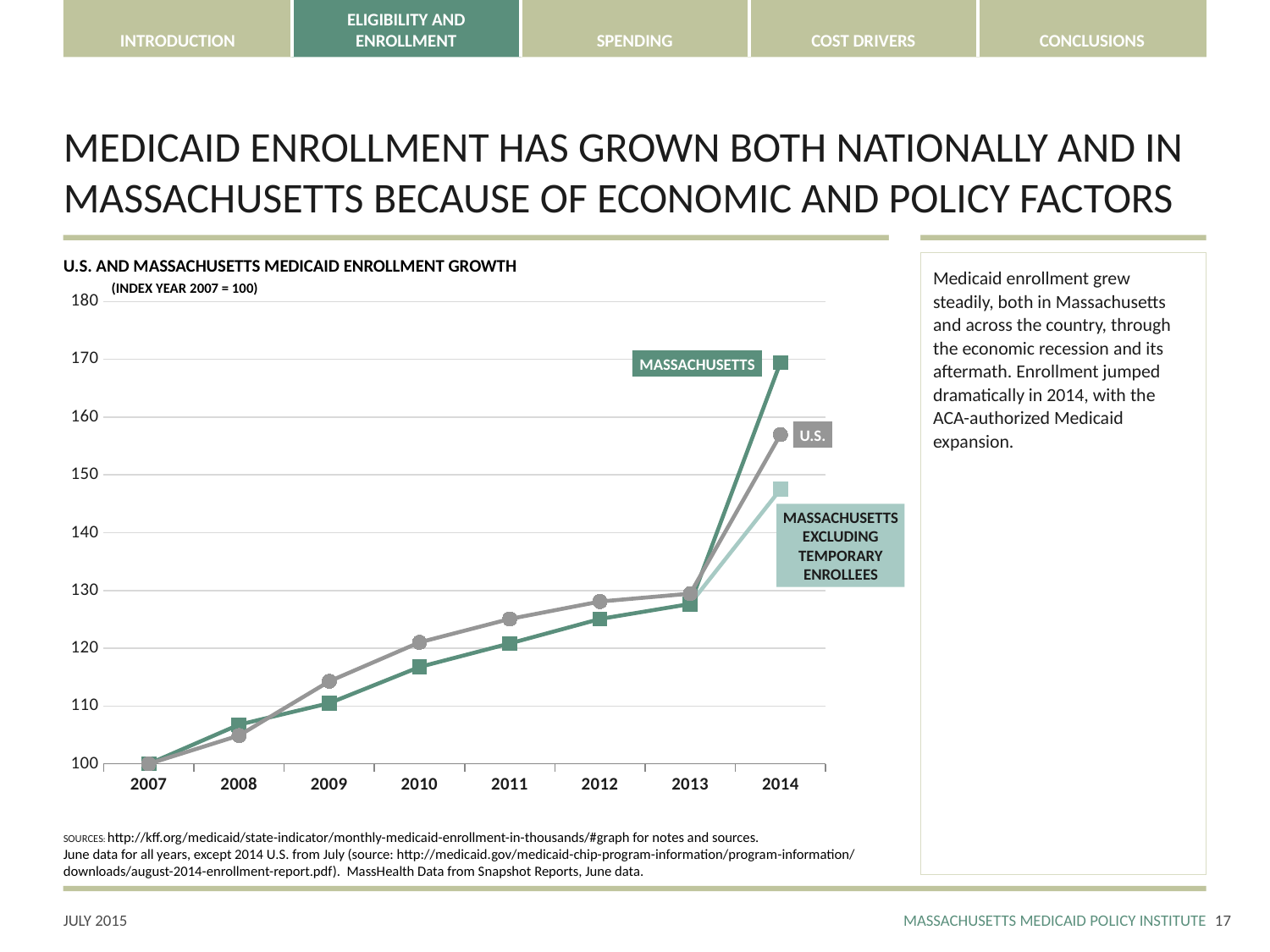
How many data series are labeled on the chart? 3 Is the value for Massachusetts in 2013 greater or less than 130? less Is the value for U.S. in 2014 greater or less than 160? less In 2014, which is larger, the Massachusetts value or the U.S. value? Massachusetts Do the Massachusetts values rise or fall from 2007 to 2014? rise Is the value for Massachusetts in 2014 greater or less than 160? greater What is the index value for Massachusetts in 2007? 100 In 2010, which is larger, the U.S. value or the Massachusetts value? U.S. What kind of chart is shown on the slide? line chart How many years are shown on the x axis of the chart? 8 What is the title of the chart? U.S. AND MASSACHUSETTS MEDICAID ENROLLMENT GROWTH